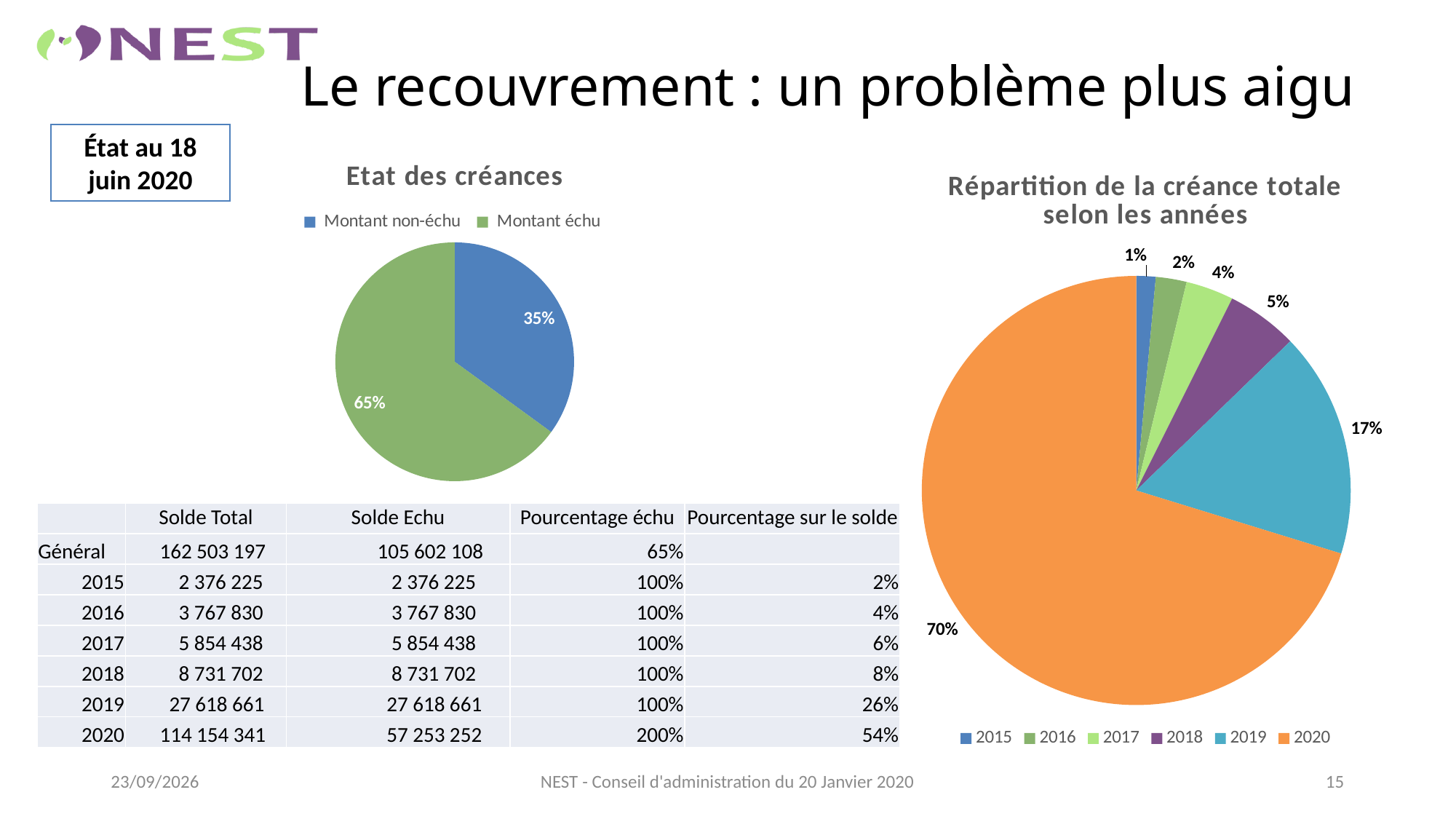
What kind of chart is 'Etat des créances'? Pie chart How many entries does the legend of the 'Etat des créances' chart list? 2 In the 'Etat des créances' chart, which slice is larger, Montant échu or Montant non-échu? Montant échu In the 'Etat des créances' chart, what share is labelled for Montant échu? 65% In the 'Répartition de la créance totale selon les années' chart, what share is labelled for 2019? 17% In the 'Répartition de la créance totale selon les années' chart, what colour is the slice for 2020? Orange In the 'Répartition de la créance totale selon les années' chart, which year has the smallest slice? 2015 In the 'Etat des créances' chart, what share is labelled for Montant non-échu? 35% How many years does the legend of the 'Répartition de la créance totale selon les années' chart list? 6 In the 'Répartition de la créance totale selon les années' chart, what share is labelled for 2020? 70% In the 'Répartition de la créance totale selon les années' chart, which year has the largest slice? 2020 In the 'Répartition de la créance totale selon les années' chart, what is the difference between the shares for 2020 and 2019? 53%